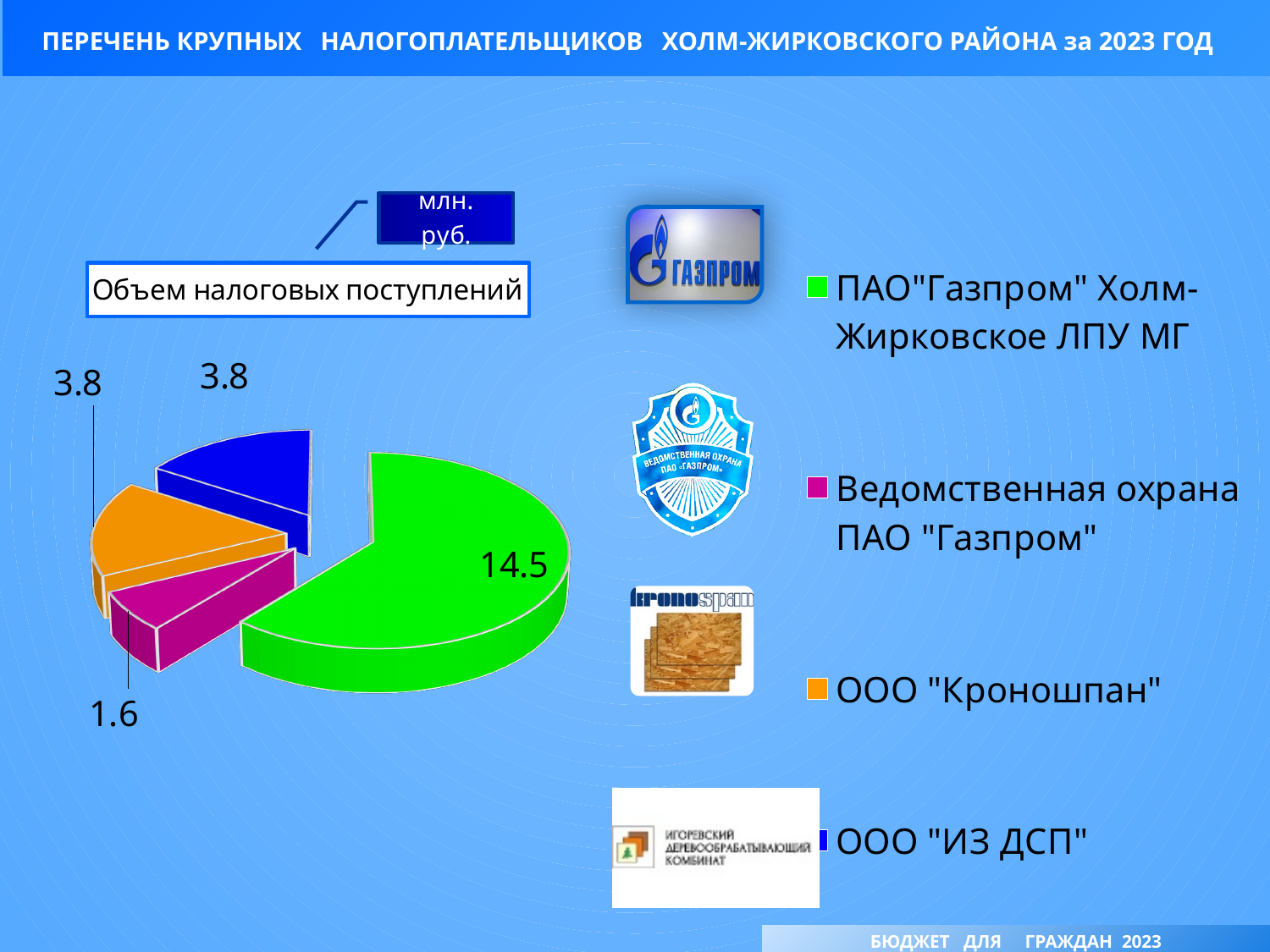
What type of chart is shown on the slide? Pie chart What is the value for ПАО "Газпром" Холм-Жирковское ЛПУ МГ? 14.5 What is the value for ООО "Кроношпан"? 3.8 What is the difference between the values for ПАО "Газпром" Холм-Жирковское ЛПУ МГ and ООО "Кроношпан"? 10.7 What is the value for Ведомственная охрана ПАО "Газпром"? 1.6 Which is larger: the value for ООО "ИЗ ДСП" or the value for Ведомственная охрана ПАО "Газпром"? ООО "ИЗ ДСП" What is the title of the chart? Объем налоговых поступлений Which taxpayer has the smallest value in the pie chart? Ведомственная охрана ПАО "Газпром" How many slices does the pie chart have? 4 Which taxpayer has the largest value in the pie chart? ПАО "Газпром" Холм-Жирковское ЛПУ МГ What is the value for ООО "ИЗ ДСП"? 3.8 In what units are the chart values given? млн. руб.